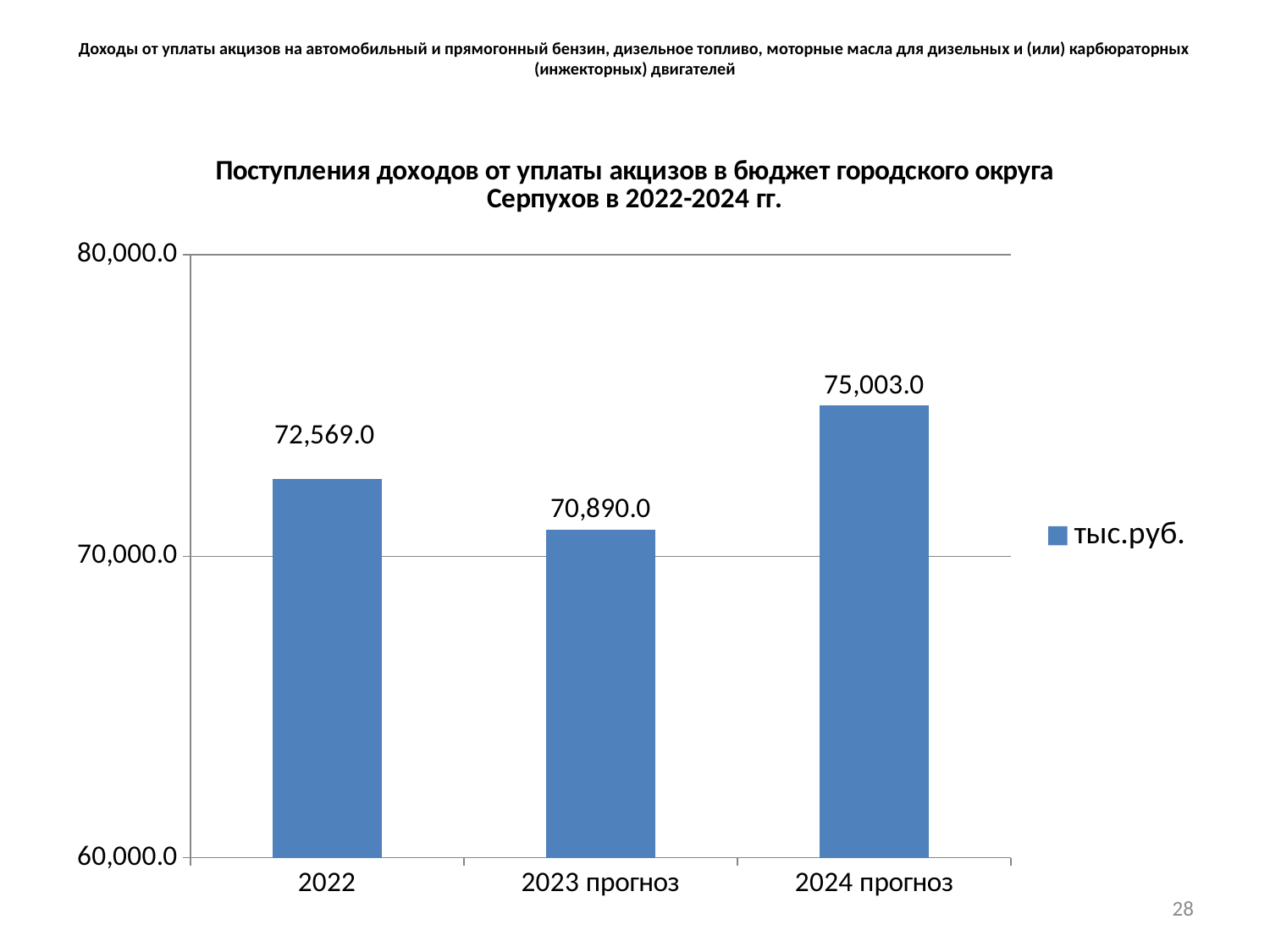
What is the value for 2022? 72,569.0 What series name does the legend show? тыс.руб. Which is larger, the value for 2022 or the value for 2023 прогноз? 2022 How many categories are shown on the x axis? 3 What is the value for 2024 прогноз? 75,003.0 What is the value for 2023 прогноз? 70,890.0 What is the difference between the values for 2022 and 2023 прогноз? 1,679.0 Is the value for 2024 прогноз greater or less than 70,000.0? greater What kind of chart is shown on the slide? bar chart Which category has the highest value? 2024 прогноз What is the difference between the values for 2024 прогноз and 2022? 2,434.0 Which category has the lowest value? 2023 прогноз